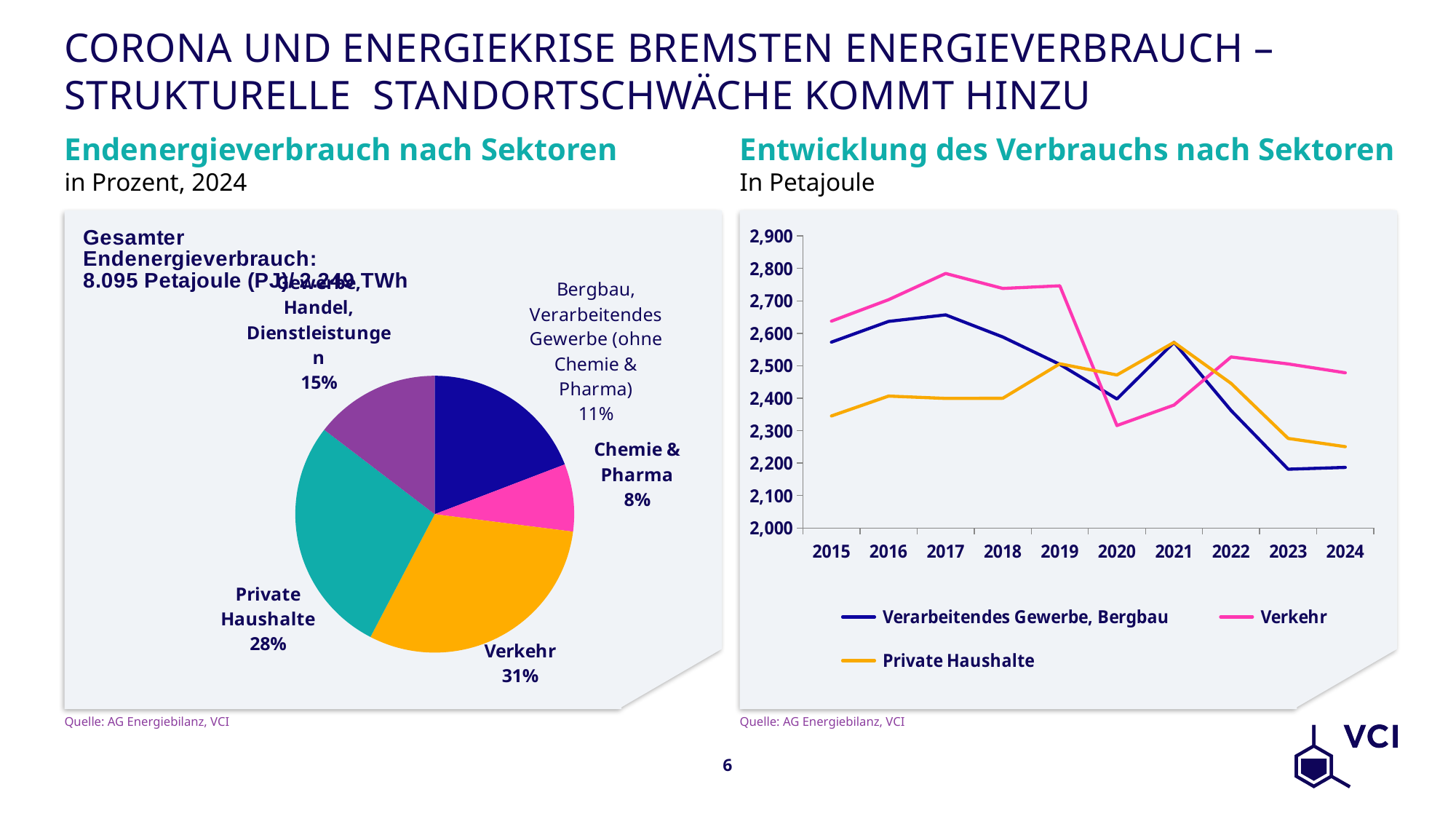
In the pie chart 'Endenergieverbrauch nach Sektoren', which is larger: Private Haushalte or Bergbau, Verarbeitendes Gewerbe (ohne Chemie & Pharma)? Private Haushalte In the pie chart 'Endenergieverbrauch nach Sektoren', which sector has the smallest share? Chemie & Pharma In the chart 'Entwicklung des Verbrauchs nach Sektoren', is the value for Verkehr in 2017 greater or less than 2,700? greater What kind of chart is 'Entwicklung des Verbrauchs nach Sektoren'? Line chart In the chart 'Entwicklung des Verbrauchs nach Sektoren', is the value for Private Haushalte in 2015 greater or less than 2,400? less In the pie chart 'Endenergieverbrauch nach Sektoren', what share does Chemie & Pharma have? 8% How many series does the legend of 'Entwicklung des Verbrauchs nach Sektoren' list? 3 In the pie chart 'Endenergieverbrauch nach Sektoren', what share does Verkehr have? 31% In the pie chart 'Endenergieverbrauch nach Sektoren', how many percentage points larger is Private Haushalte than Gewerbe, Handel, Dienstleistungen? 13 percentage points In the pie chart 'Endenergieverbrauch nach Sektoren', which sector has the largest share? Verkehr In the pie chart 'Endenergieverbrauch nach Sektoren', how many slices are there? 5 In the chart 'Entwicklung des Verbrauchs nach Sektoren', does the line for Verarbeitendes Gewerbe, Bergbau rise or fall overall from 2015 to 2024? fall